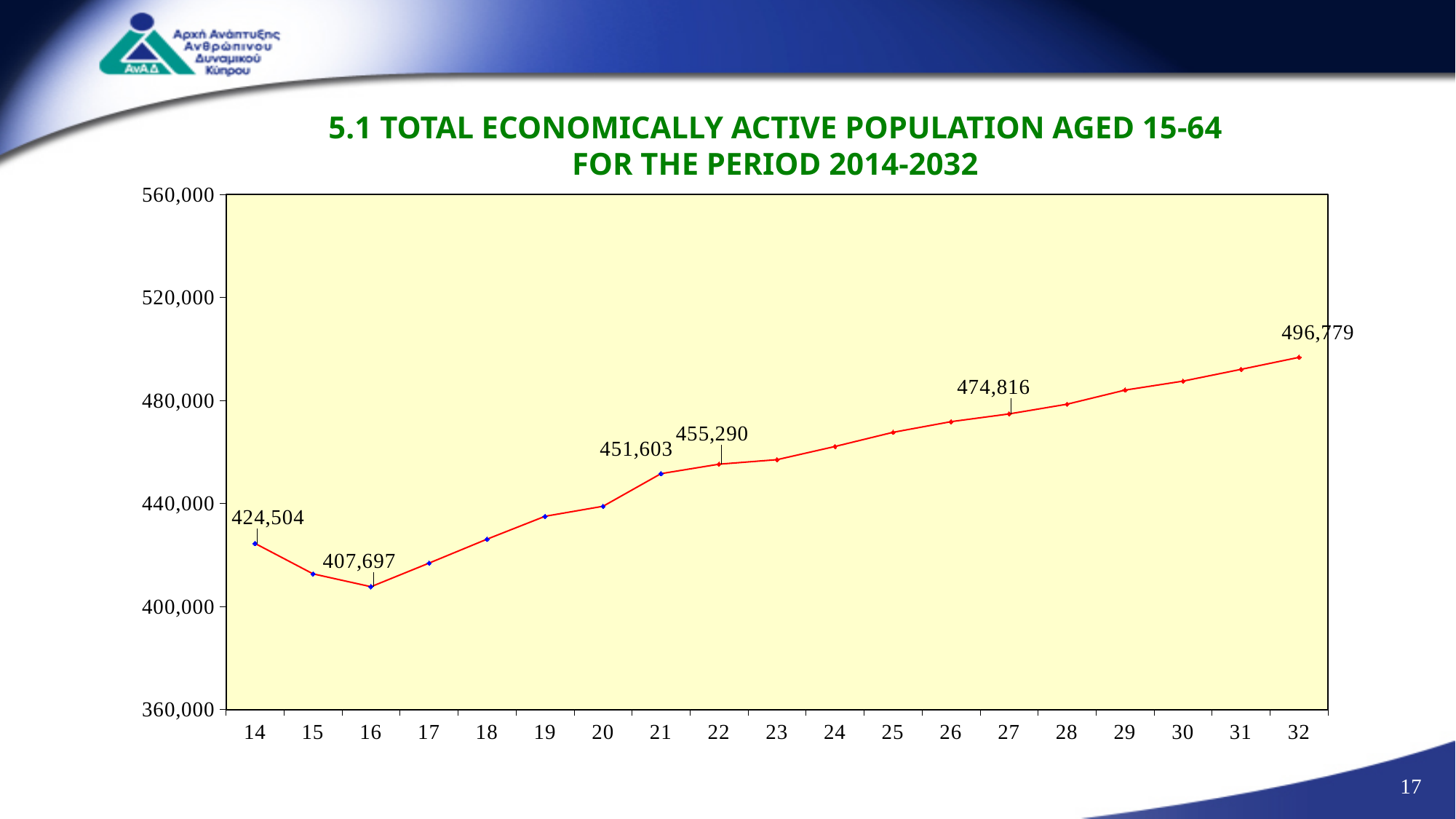
What is the value for 32 on the chart? 496,779 What is the value for 27 on the chart? 474,816 Is the value for 25 greater or less than 480,000? less What is the difference between the values for 14 and 16? 16,807 What is the difference between the values for 32 and 14? 72,275 What is the value for 14 on the chart? 424,504 How many data points are plotted on the chart? 19 Which year on the x axis has the highest value? 32 Which year on the x axis has the lowest value? 16 Which is larger, the value for 21 or the value for 22? 22 Is the value for 30 greater or less than 480,000? greater What kind of chart is shown on the slide? line chart